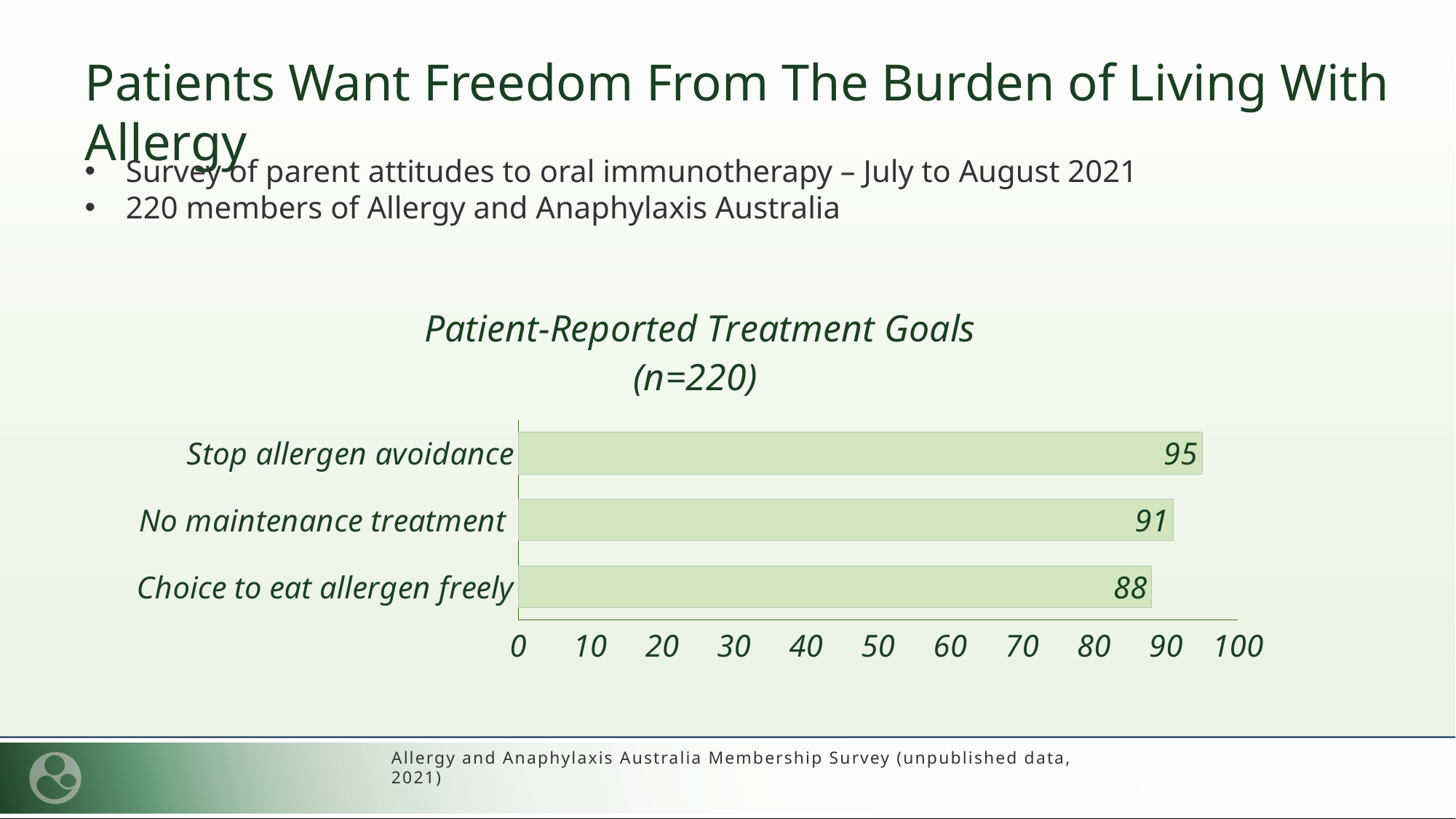
What is the value for No maintenance treatment? 91 What is the value for Stop allergen avoidance? 95 What is the title of the chart? Patient-Reported Treatment Goals (n=220) Which is larger, the value for Stop allergen avoidance or the value for No maintenance treatment? Stop allergen avoidance What is the value for Choice to eat allergen freely? 88 Is the value for Choice to eat allergen freely greater or less than 90? less Which treatment goal has the lowest value? Choice to eat allergen freely What is the difference between the values for Stop allergen avoidance and Choice to eat allergen freely? 7 What kind of chart is shown on the slide? bar chart How many categories are shown in the chart? 3 What is the difference between the values for No maintenance treatment and Choice to eat allergen freely? 3 Which treatment goal has the highest value? Stop allergen avoidance